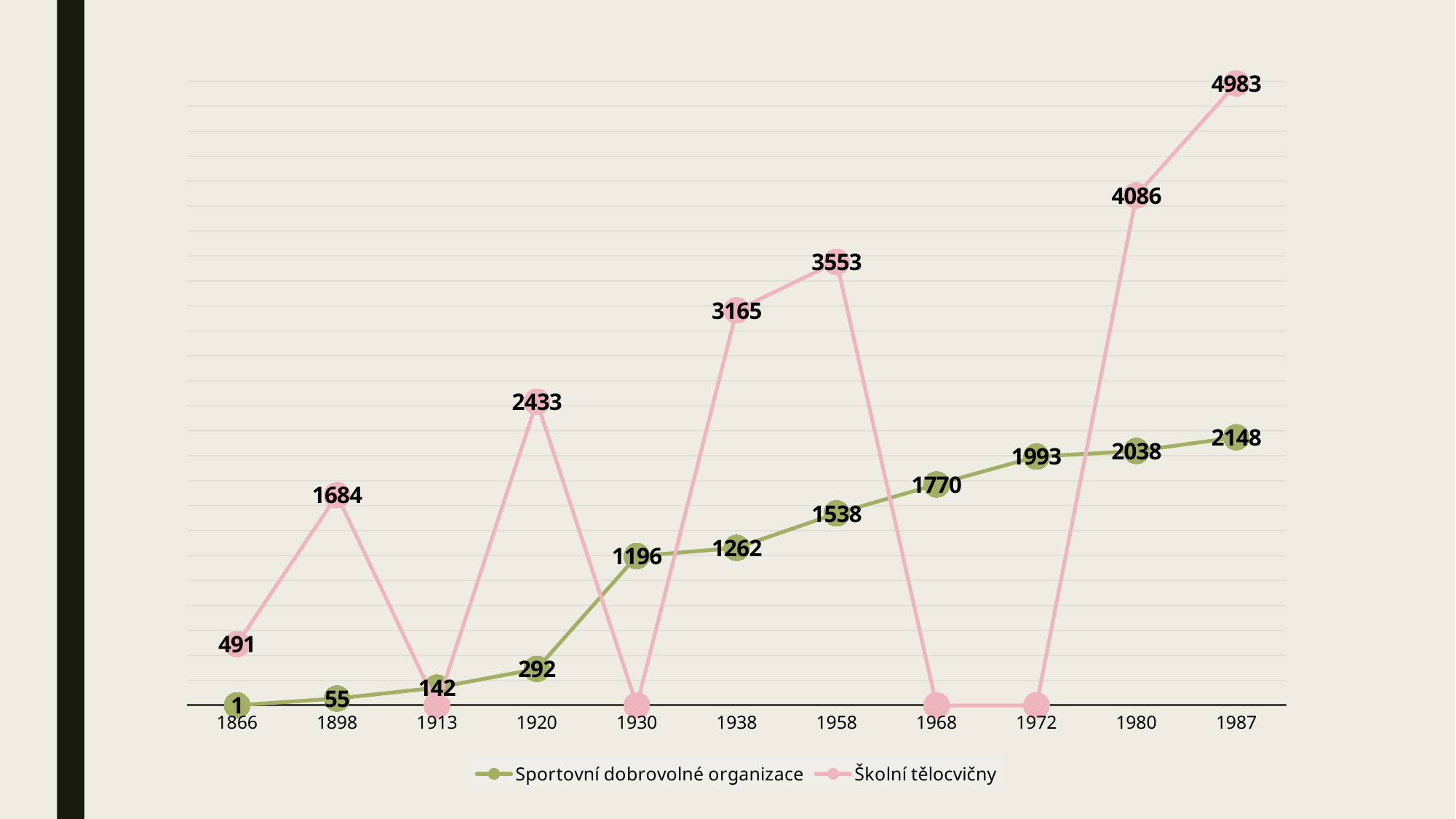
Does the value for Sportovní dobrovolné organizace rise or fall from 1866 to 1987? rise In which year is the value for Sportovní dobrovolné organizace lowest? 1866 What is the value for Školní tělocvičny in 1920? 2433 What type of chart is shown on the slide? line chart What is the value for Sportovní dobrovolné organizace in 1987? 2148 What is the difference between Školní tělocvičny and Sportovní dobrovolné organizace in 1987? 2835 What colour is the line for Školní tělocvičny? pink Which series has the larger value in 1958? Školní tělocvičny How many series does the legend list? 2 In which year does Školní tělocvičny reach its highest labelled value? 1987 What is the value for Sportovní dobrovolné organizace in 1930? 1196 How many years are shown on the x axis? 11